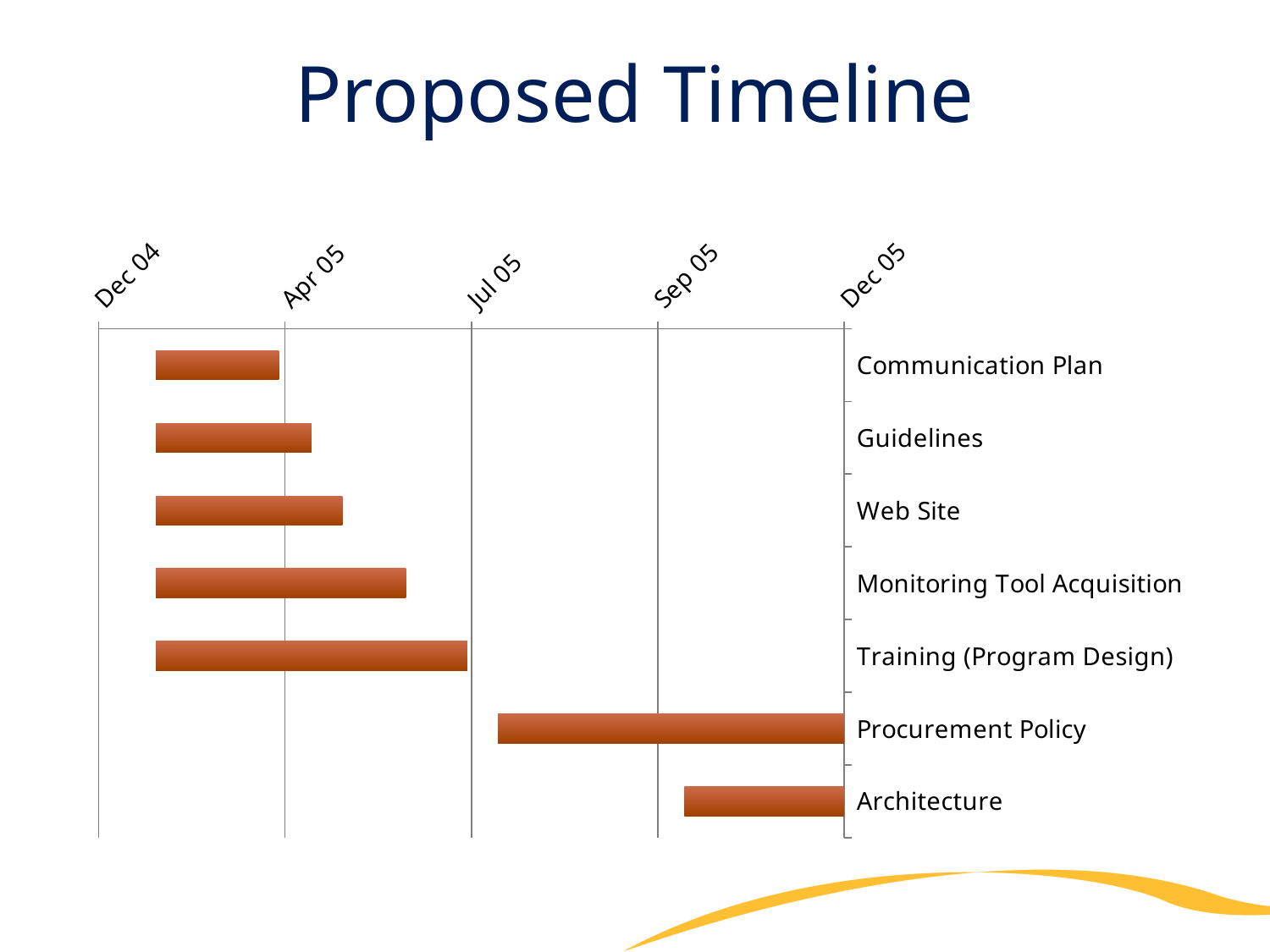
Which task has the shortest bar? Communication Plan Does the Architecture bar start before or after Sep 05? after Does the Communication Plan bar end before or after Apr 05? before What type of chart is shown on the slide? bar chart Which bar is longer, Web Site or Guidelines? Web Site Which task starts later, Procurement Policy or Architecture? Architecture Does the Monitoring Tool Acquisition bar end before or after Jul 05? before Which task is listed last (at the bottom) on the chart? Architecture How many tasks are listed on the chart? 7 How many date labels are shown along the time axis? 5 What is the title of the slide? Proposed Timeline